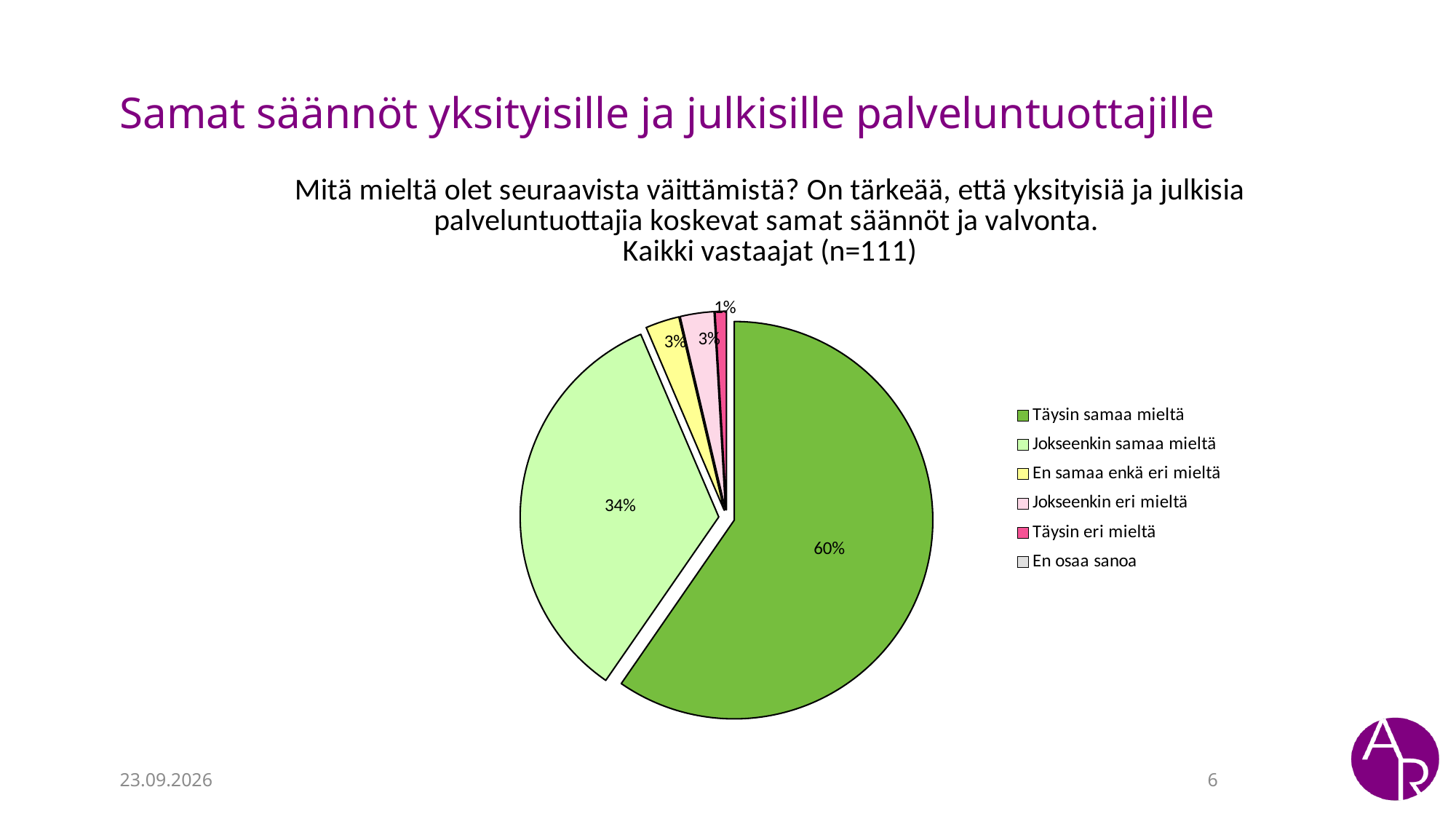
Which of the two is larger: "Jokseenkin samaa mieltä" or "Jokseenkin eri mieltä"? Jokseenkin samaa mieltä What share of respondents answered "En samaa enkä eri mieltä"? 3% What colour is the "Täysin eri mieltä" slice in the legend? pink How many respondents (n) does the chart subtitle state? 111 What share of respondents answered "Jokseenkin samaa mieltä"? 34% What is the difference in percentage points between "Täysin samaa mieltä" and "Jokseenkin samaa mieltä"? 26 What share of respondents answered "Täysin eri mieltä"? 1% What kind of chart is shown on the slide? pie chart How many entries does the legend list? 6 Which response category has the largest slice of the pie? Täysin samaa mieltä What share of respondents answered "Täysin samaa mieltä"? 60% What is the combined share of "Täysin samaa mieltä" and "Jokseenkin samaa mieltä"? 94%